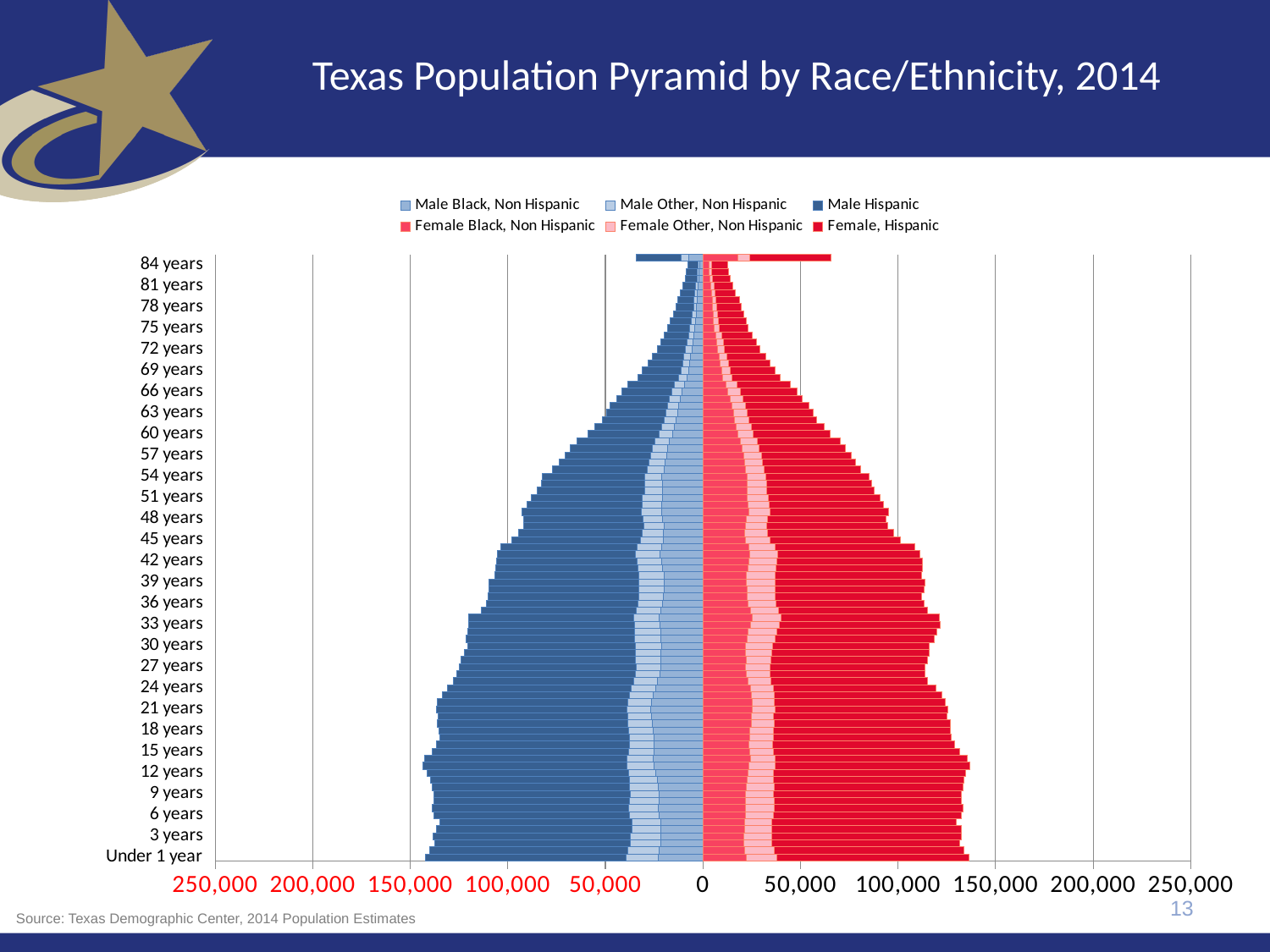
Which age group has the longer total male bar: Under 1 year or 84 years? Under 1 year What kind of chart is shown on the slide? Bar chart (population pyramid) Do the bars generally get longer or shorter as age increases from Under 1 year toward 84 years? shorter Which legend entry is shown in the darkest blue? Male Hispanic What is the title of the chart? Texas Population Pyramid by Race/Ethnicity, 2014 Which is larger for Under 1 year: the Male Hispanic segment or the Male Other, Non Hispanic segment? Male Hispanic Is the total female bar for 33 years greater or less than 100,000? greater Is the total male bar for Under 1 year greater or less than 100,000? greater How many series does the legend list? 6 Is the total female bar for Under 1 year greater or less than 100,000? greater